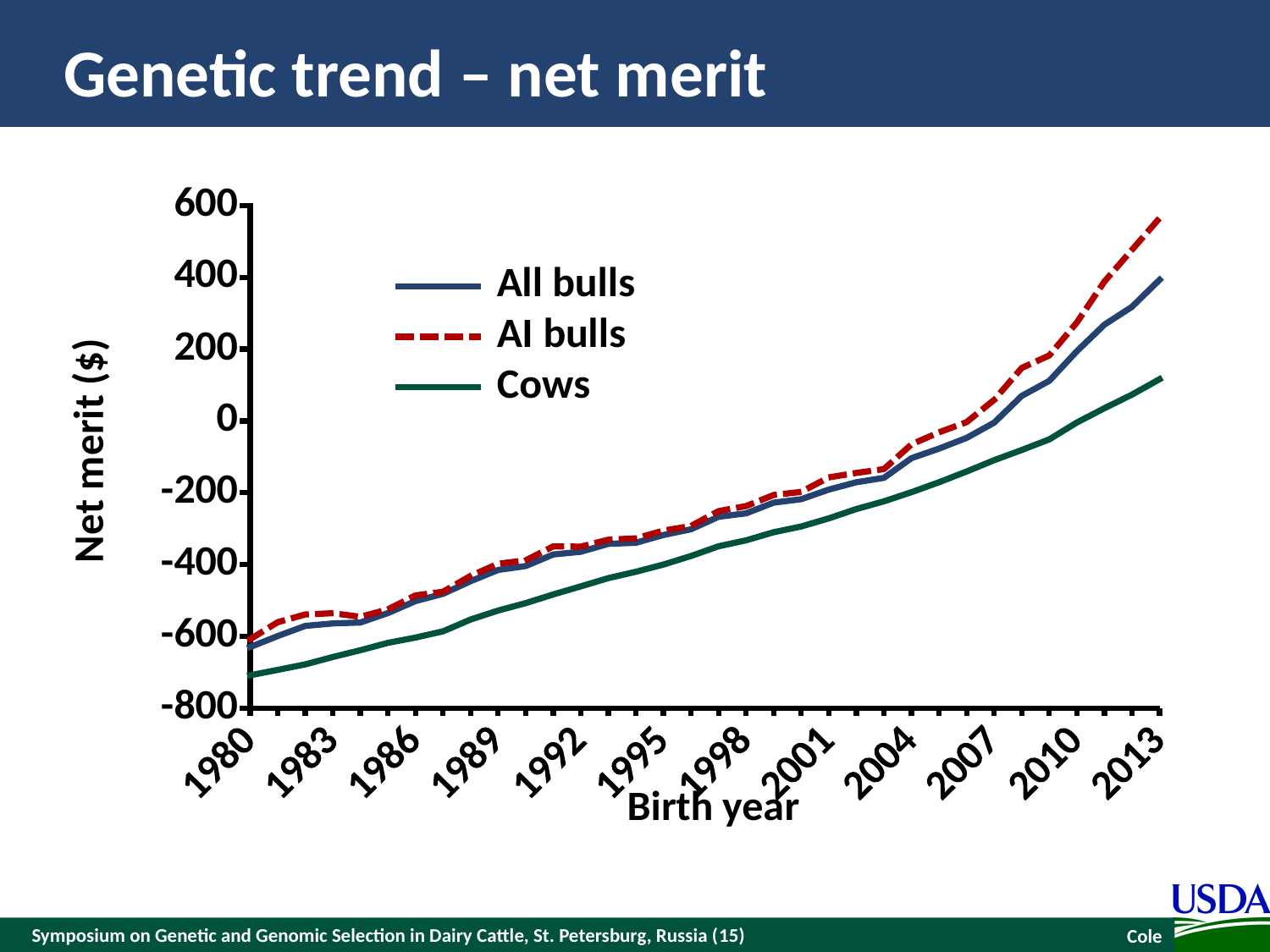
Which series has the lowest net merit at birth year 2013? Cows Is the net merit for Cows at birth year 1980 greater or less than -600? less Is the net merit for Cows at birth year 2013 greater or less than 0? greater What kind of chart is shown on the slide? line chart At birth year 1980, which is higher: the net merit for All bulls or for Cows? All bulls Is the net merit for AI bulls at birth year 2013 greater or less than 400? greater Which series has the highest net merit at birth year 2013? AI bulls How many series does the legend list? 3 What is the title of the slide's chart? Genetic trend – net merit Do the net merit values rise or fall from 1980 to 2013 for the Cows series? rise How many birth-year labels are shown on the x axis? 12 Which series are listed in the legend? All bulls, AI bulls, Cows